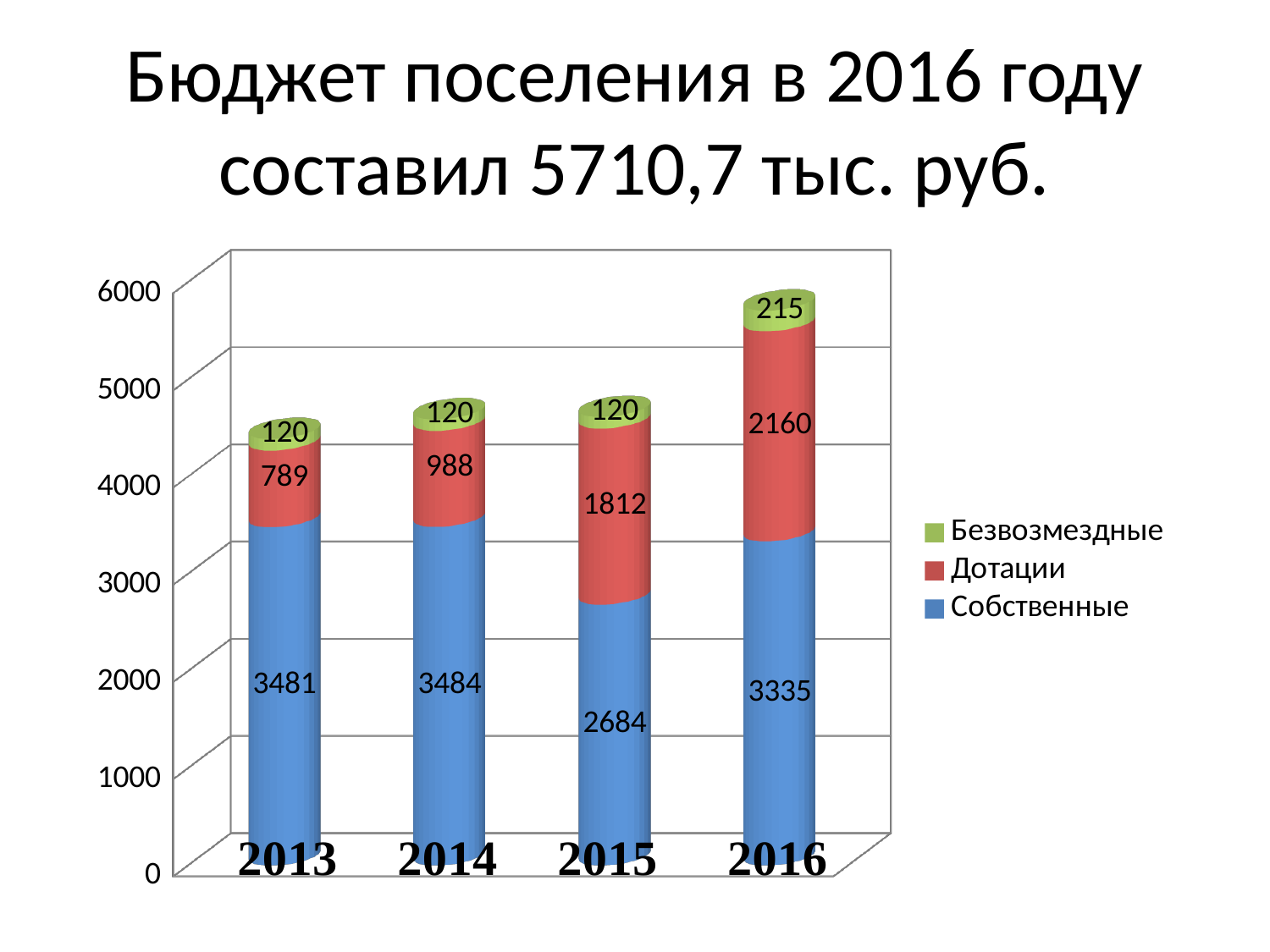
What is the total of the stacked bar for 2016? 5710 Which is larger, the Собственные value for 2014 or for 2016? 2014 What is the difference between the Дотации values for 2016 and 2015? 348 What kind of chart is shown on the slide? Stacked bar chart In which year is the Дотации value the highest? 2016 What is the value of Дотации for 2016? 2160 What is the total of the stacked bar for 2013? 4390 How many years are shown on the x axis? 4 What is the value of Собственные for 2013? 3481 How many series does the legend list? 3 In which year is the Собственные value the lowest? 2015 What is the value of Безвозмездные for 2016? 215